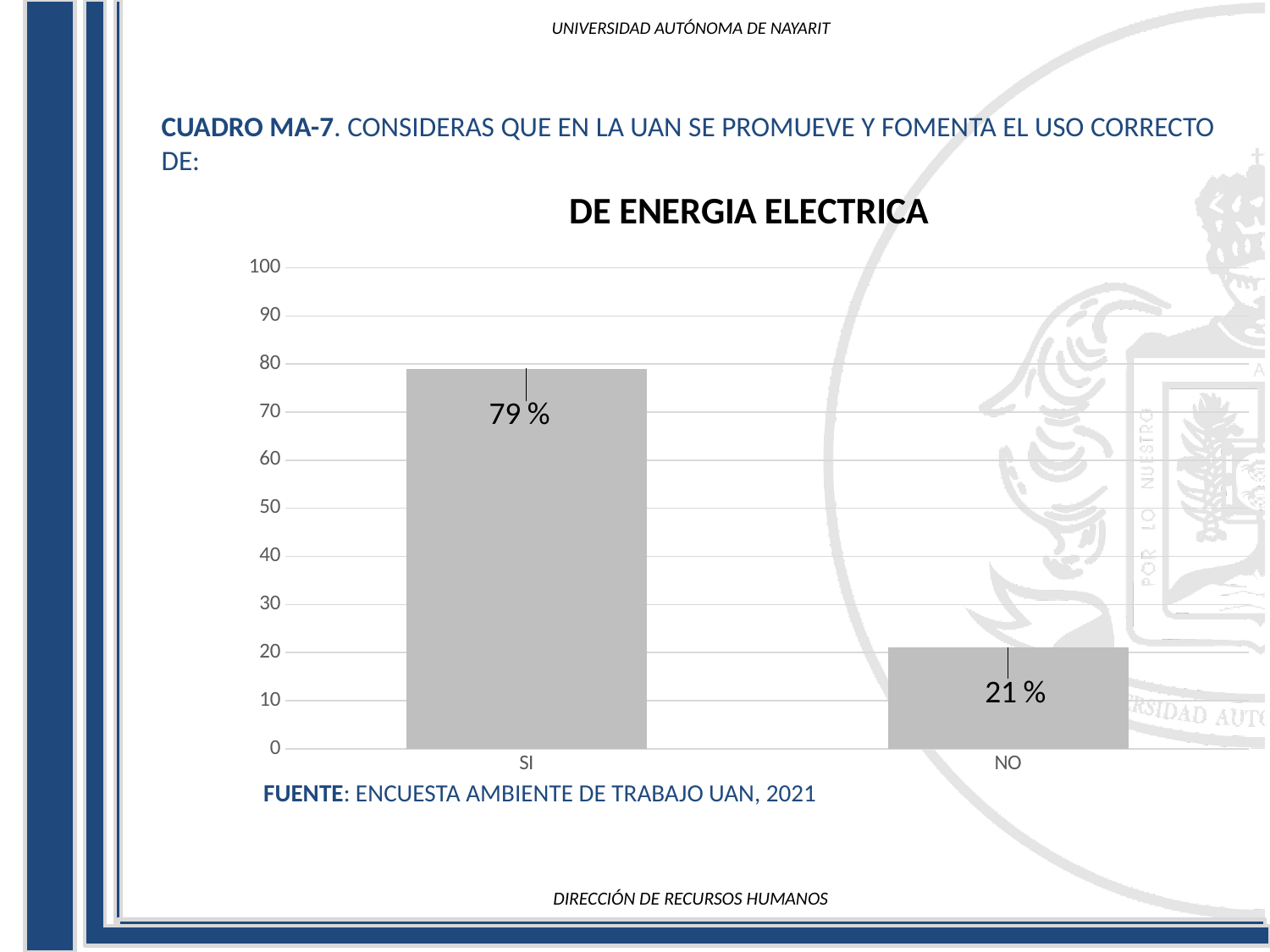
Which is larger, the value for SI or the value for NO? SI What is the title of the chart? DE ENERGIA ELECTRICA What is the value for SI? 79 % How many categories are shown on the x axis? 2 Is the value for NO greater or less than 30? less Is the value for SI greater or less than 50? greater What is the value for NO? 21 % What kind of chart is shown on the slide? bar chart Which category has the highest value? SI What is the difference between the values for SI and NO? 58 % Which category has the lowest value? NO What is the maximum value shown on the vertical axis? 100